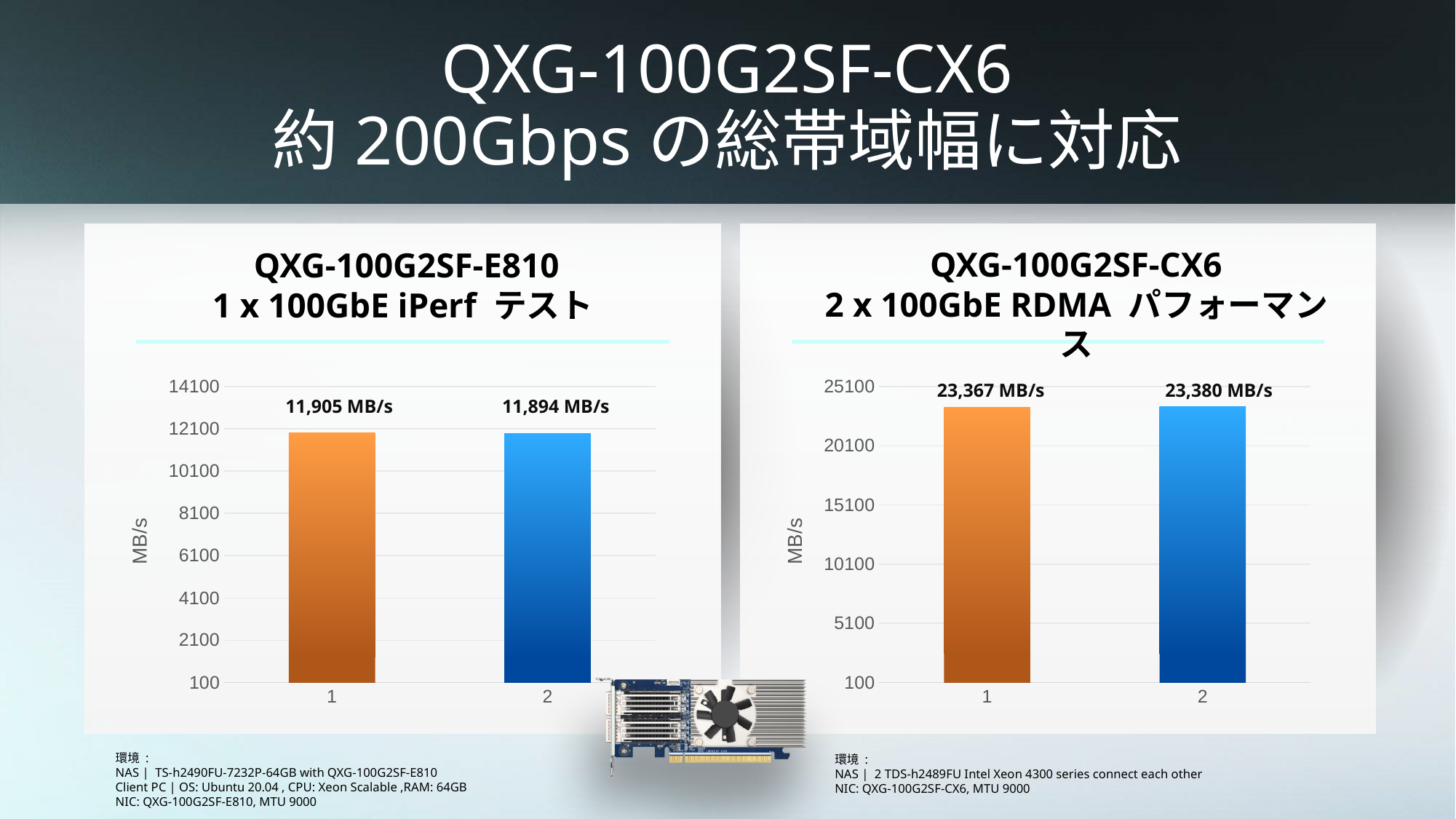
In the right chart (QXG-100G2SF-CX6 2 x 100GbE RDMA パフォーマンス), what is the value for category 1? 23,367 MB/s In the left chart (QXG-100G2SF-E810 1 x 100GbE iPerf テスト), what is the value for category 1? 11,905 MB/s In the left chart (QXG-100G2SF-E810 1 x 100GbE iPerf テスト), what is the value for category 2? 11,894 MB/s What kind of chart is the left chart (QXG-100G2SF-E810 1 x 100GbE iPerf テスト)? Bar chart In the left chart (QXG-100G2SF-E810 1 x 100GbE iPerf テスト), what is the difference between the values for category 1 and category 2? 11 MB/s In the right chart (QXG-100G2SF-CX6 2 x 100GbE RDMA パフォーマンス), what is the value for category 2? 23,380 MB/s In the left chart (QXG-100G2SF-E810 1 x 100GbE iPerf テスト), what colour is the bar for category 2? Blue In the left chart (QXG-100G2SF-E810 1 x 100GbE iPerf テスト), which category has the higher value, 1 or 2? 1 In the right chart (QXG-100G2SF-CX6 2 x 100GbE RDMA パフォーマンス), which category has the higher value, 1 or 2? 2 In the right chart (QXG-100G2SF-CX6 2 x 100GbE RDMA パフォーマンス), what is the difference between the values for category 2 and category 1? 13 MB/s What is the y-axis label of the right chart (QXG-100G2SF-CX6 2 x 100GbE RDMA パフォーマンス)? MB/s How many bars are plotted in the right chart (QXG-100G2SF-CX6 2 x 100GbE RDMA パフォーマンス)? 2